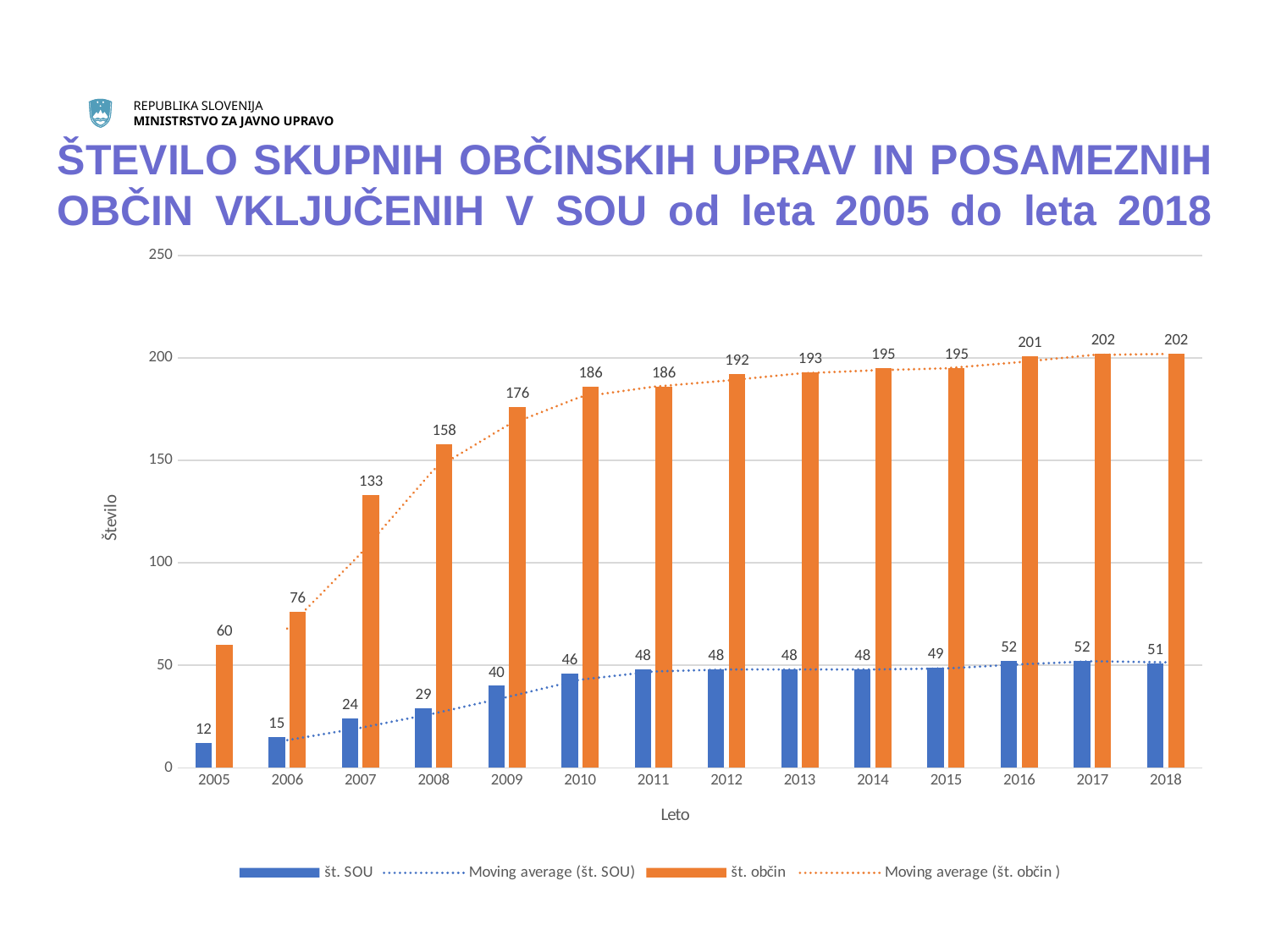
What colour are the št. občin bars? Orange What is the value of št. SOU in 2012? 48 What is the label of the y axis? Število In which year is št. občin lowest? 2005 What kind of chart is this? Bar chart with moving average lines Does št. občin rise or fall from 2005 to 2018? Rise What is the value of št. občin in 2009? 176 Which is larger: št. SOU in 2007 or št. SOU in 2010? 2010 How many entries does the legend list? 4 What is the difference between št. občin in 2018 and in 2005? 142 How many years are shown on the x axis? 14 In which year is št. SOU highest? 2016 and 2017